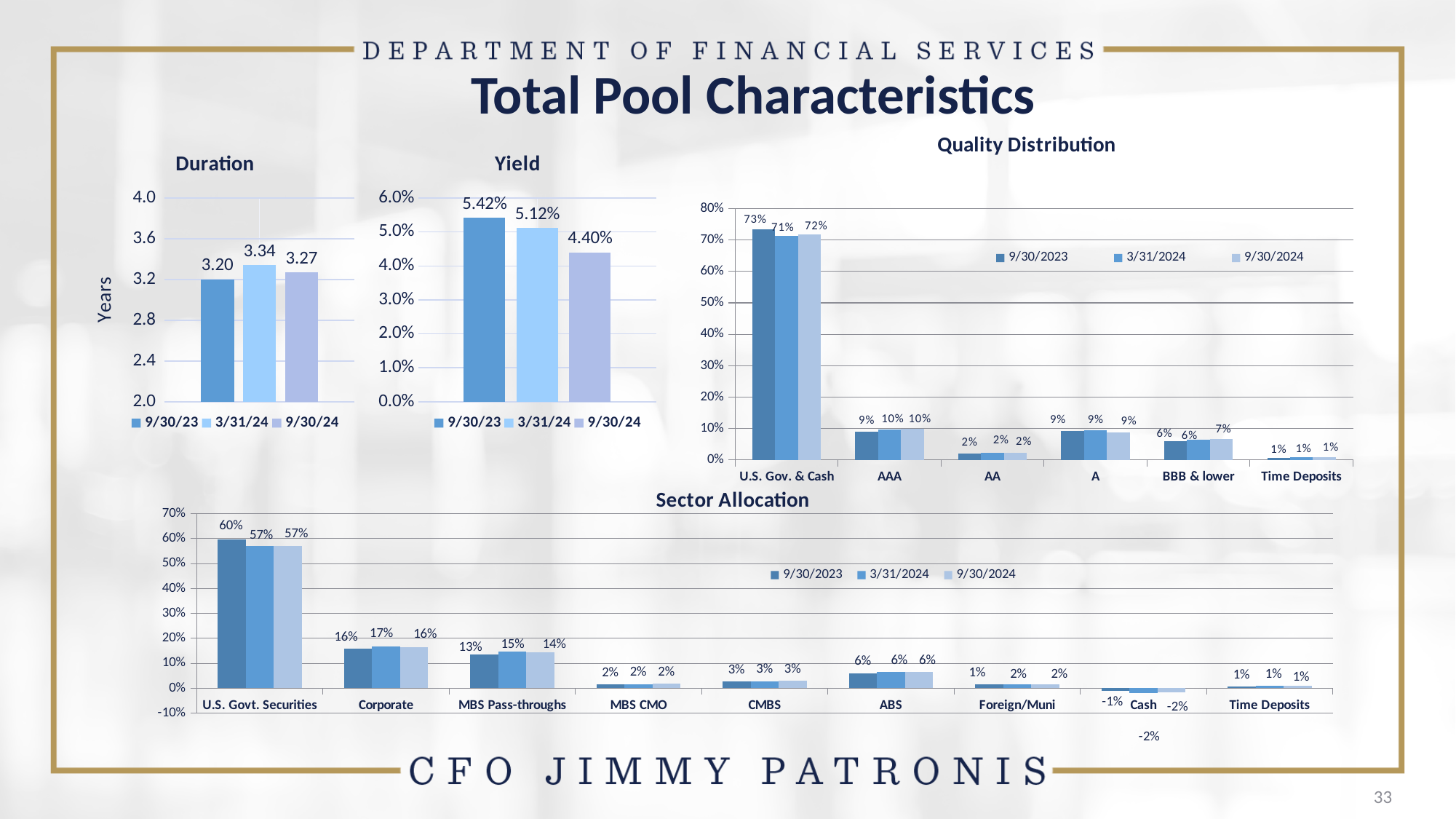
In the Sector Allocation chart, how many series does the legend list? 3 In the Quality Distribution chart, which category has the highest values? U.S. Gov. & Cash What kind of chart is the Sector Allocation chart? bar chart In the Quality Distribution chart, how many categories are shown on the x axis? 6 In the Quality Distribution chart, what is the value for BBB & lower on 9/30/2024? 7% In the Duration chart, which period has the highest value? 3/31/24 In the Duration chart, what is the value for 3/31/24? 3.34 In the Yield chart, what is the value for 9/30/24? 4.40% In the Yield chart, what is the difference between the 9/30/23 and 9/30/24 values? 1.02% In the Sector Allocation chart, which category has the lowest values? Cash In the Sector Allocation chart, what is the value for MBS Pass-throughs on 3/31/2024? 15% In the Yield chart, do the values rise or fall from 9/30/23 to 9/30/24? fall